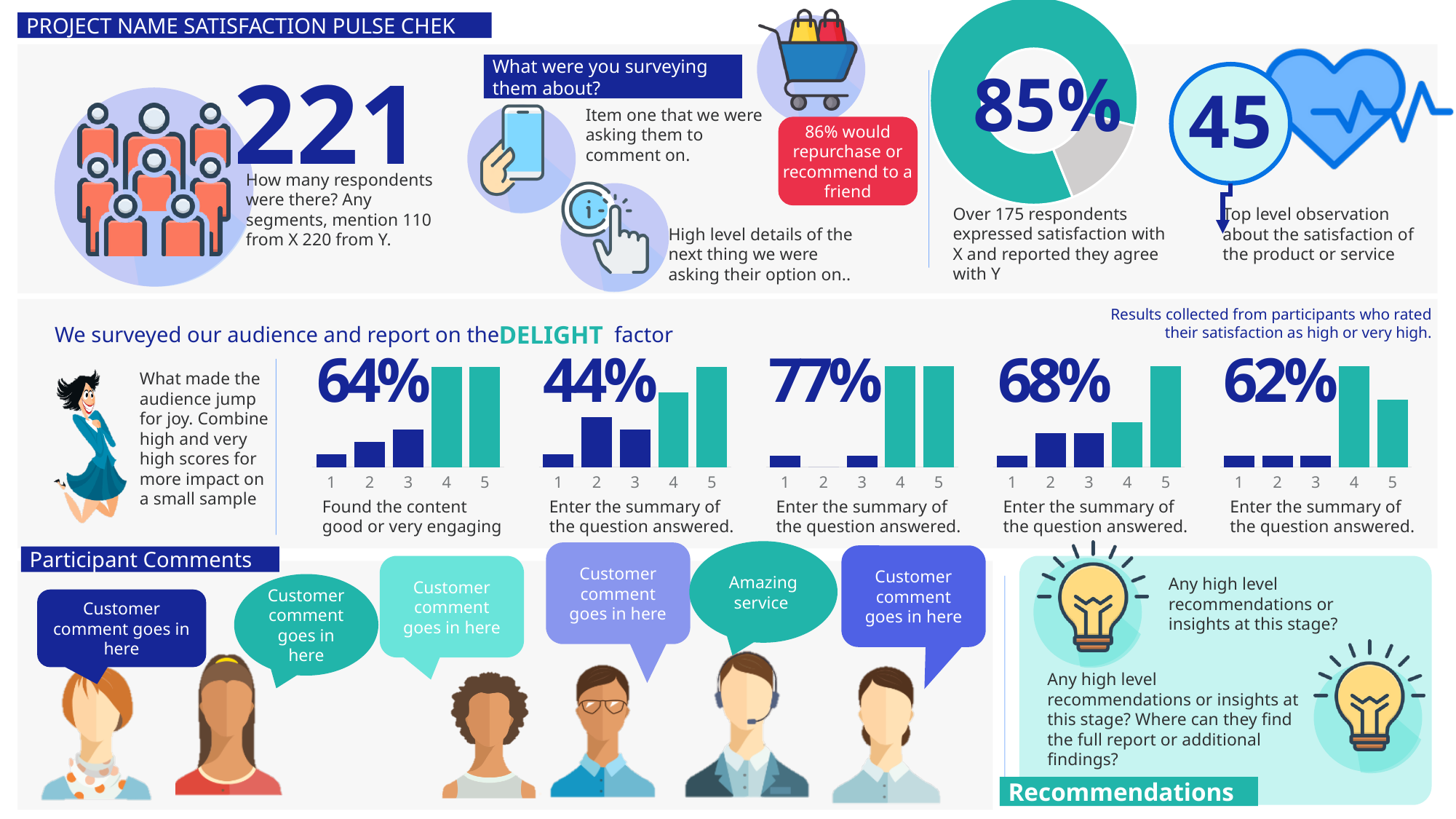
In the donut chart at the top of the slide, what share is shown by the large teal segment? 85% In the bar chart labelled 64%, which bar is taller, category 2 or category 3? 3 In the bar chart labelled 77%, which category has the lowest bar? 2 How many categories are shown on the x axis of the bar chart labelled 64%? 5 What kind of chart is the chart showing 85% at the top of the slide? Donut chart In the bar chart labelled 62%, which category has the highest bar? 4 What headline percentage is printed next to the bar chart captioned 'Found the content good or very engaging'? 64% In the bar chart labelled 68%, which category has the highest bar? 5 In the bar chart labelled 44%, which category has the highest bar? 5 What kind of chart is the chart labelled 64% (Found the content good or very engaging)? Bar chart In the bar chart labelled 64%, which category has the lowest bar? 1 In the bar chart labelled 44%, which bar is taller, category 2 or category 3? 2